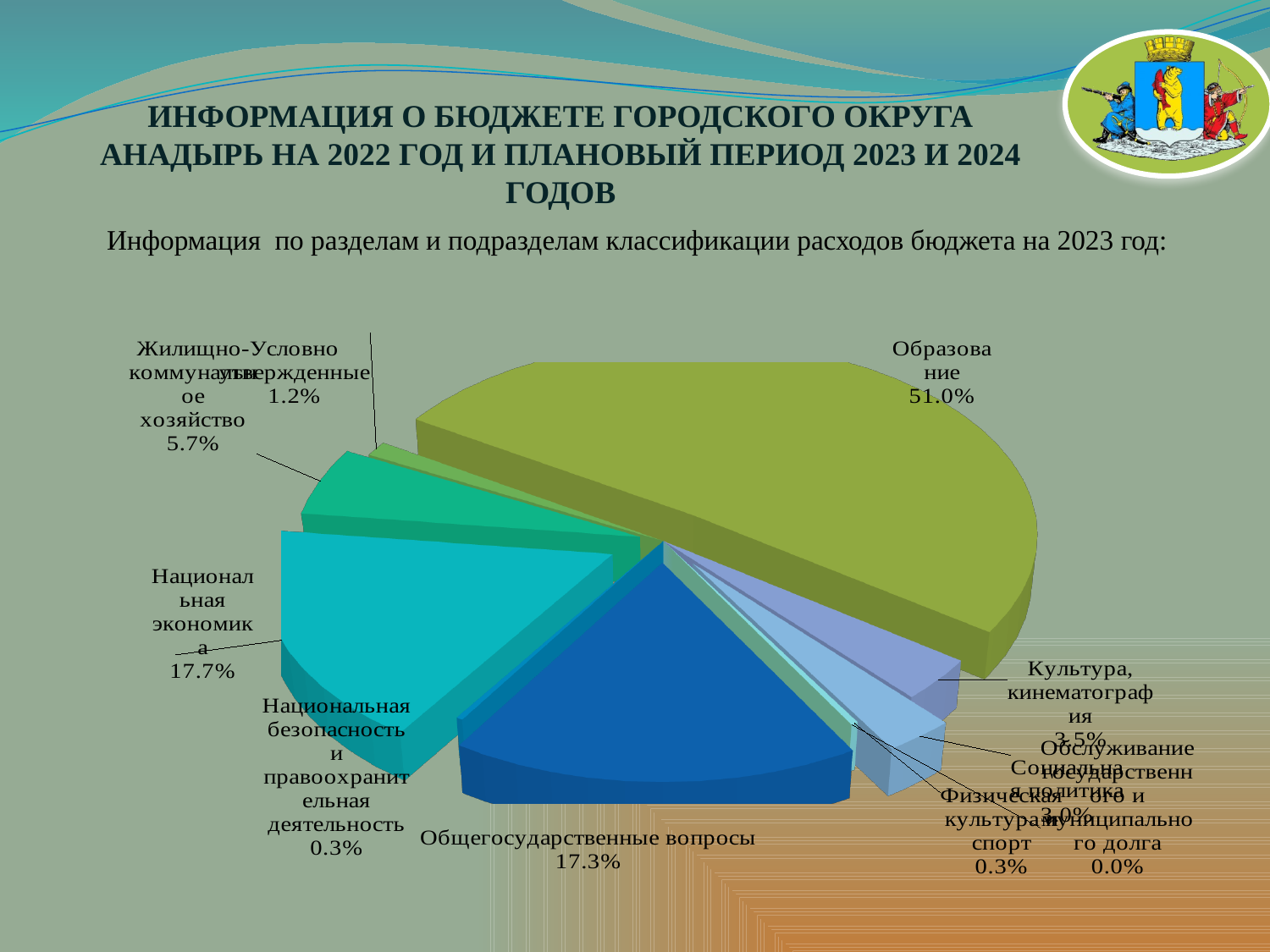
What is the value shown for Культура, кинематография? 3.5% What is the value shown for Общегосударственные вопросы? 17.3% What is the value shown for Национальная экономика? 17.7% What is the value shown for Жилищно-коммунальное хозяйство? 5.7% How many categories (slices) does the pie chart have? 10 What kind of chart is shown on the slide? pie chart Which is larger: the share of Образование or the share of Национальная экономика? Образование Which category has the largest share of the pie? Образование What is the difference between the shares of Национальная экономика and Общегосударственные вопросы? 0.4% What is the value shown for Условно утвержденные? 1.2% Which category has the smallest share of the pie? Обслуживание государственного и муниципального долга What share of the 2023 budget expenditures goes to Образование? 51.0%